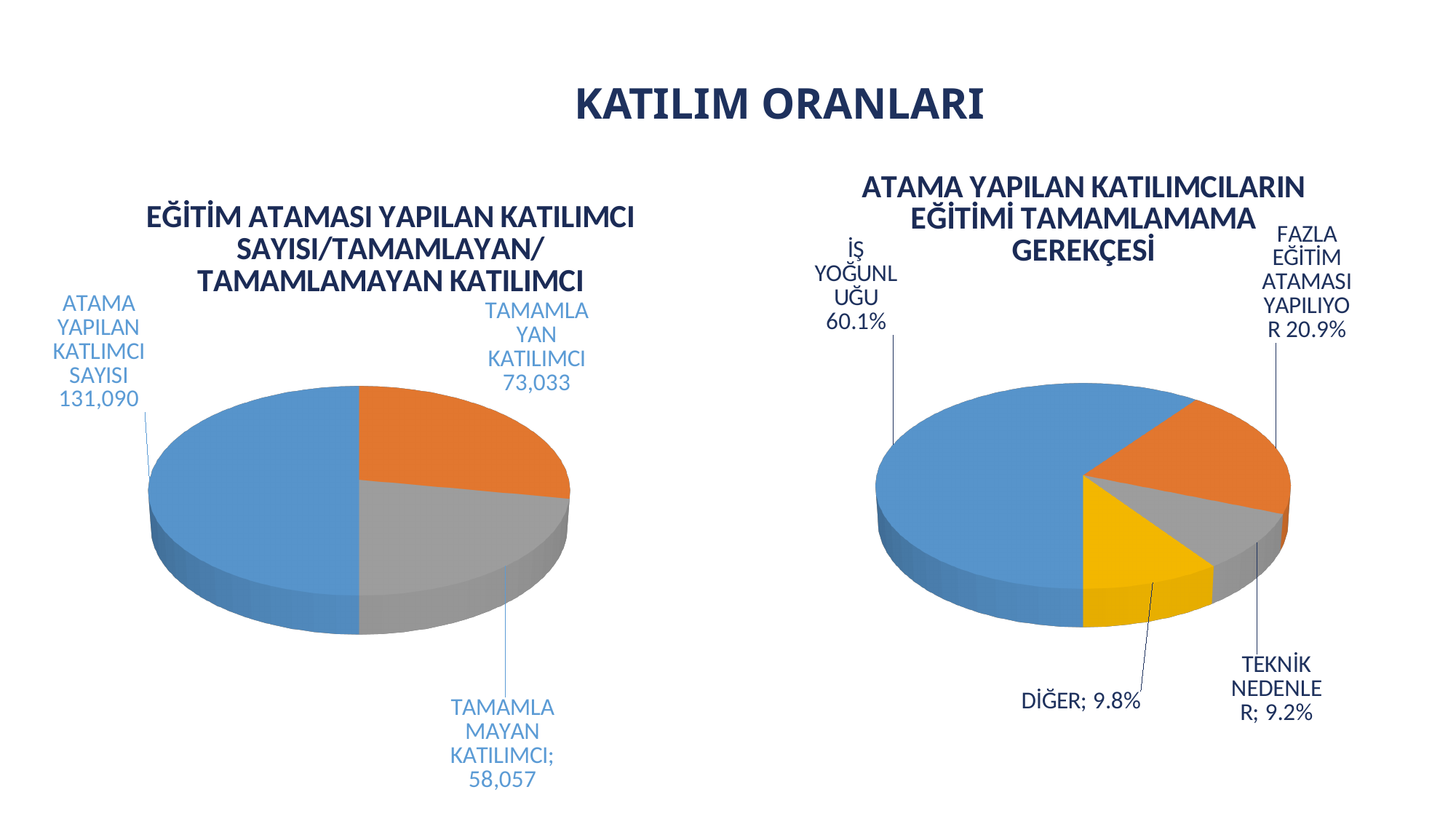
On the left chart, what is the value for ATAMA YAPILAN KATILIMCI SAYISI? 131,090 On the right chart, what share is shown for İŞ YOĞUNLUĞU? 60.1% On the right chart, what share is shown for DİĞER? 9.8% On the right chart, which is larger: İŞ YOĞUNLUĞU or FAZLA EĞİTİM ATAMASI YAPILIYOR? İŞ YOĞUNLUĞU On the right chart, which category has the largest share? İŞ YOĞUNLUĞU On the right chart, what share is shown for FAZLA EĞİTİM ATAMASI YAPILIYOR? 20.9% On the left chart, what is the value for TAMAMLAMAYAN KATILIMCI? 58,057 On the left chart, what is the difference between TAMAMLAYAN KATILIMCI and TAMAMLAMAYAN KATILIMCI? 14,976 On the left chart, which category has the largest value? ATAMA YAPILAN KATILIMCI SAYISI On the left chart, how many slices does the pie have? 3 What kind of chart is the chart on the right? Pie chart On the left chart, what is the value for TAMAMLAYAN KATILIMCI? 73,033